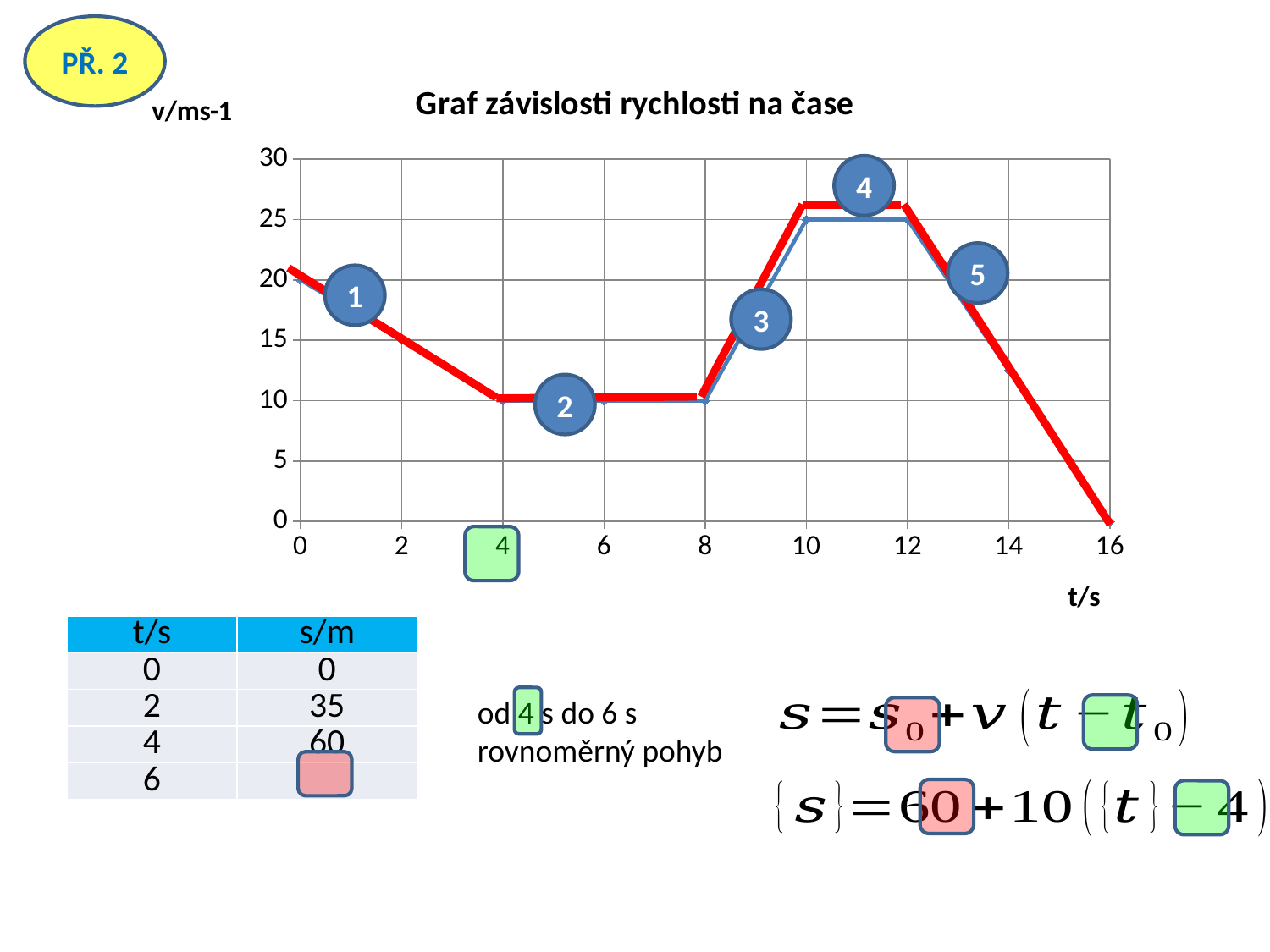
What kind of chart is shown on the slide? line chart What is the velocity value at t = 4 s? 10 Is the velocity value at t = 0 s greater or less than 15? greater What is the title of the chart? Graf závislosti rychlosti na čase Does the velocity rise or fall between t = 0 s and t = 4 s? fall Is the velocity value at t = 14 s greater or less than 15? less Does the velocity rise or fall between t = 8 s and t = 10 s? rise What is the velocity value at t = 6 s? 10 What is the velocity value at t = 16 s? 0 Is the velocity value at t = 10 s greater or less than 20? greater At which time does the velocity reach its lowest value? 16 What is the label of the horizontal axis of the chart? t/s